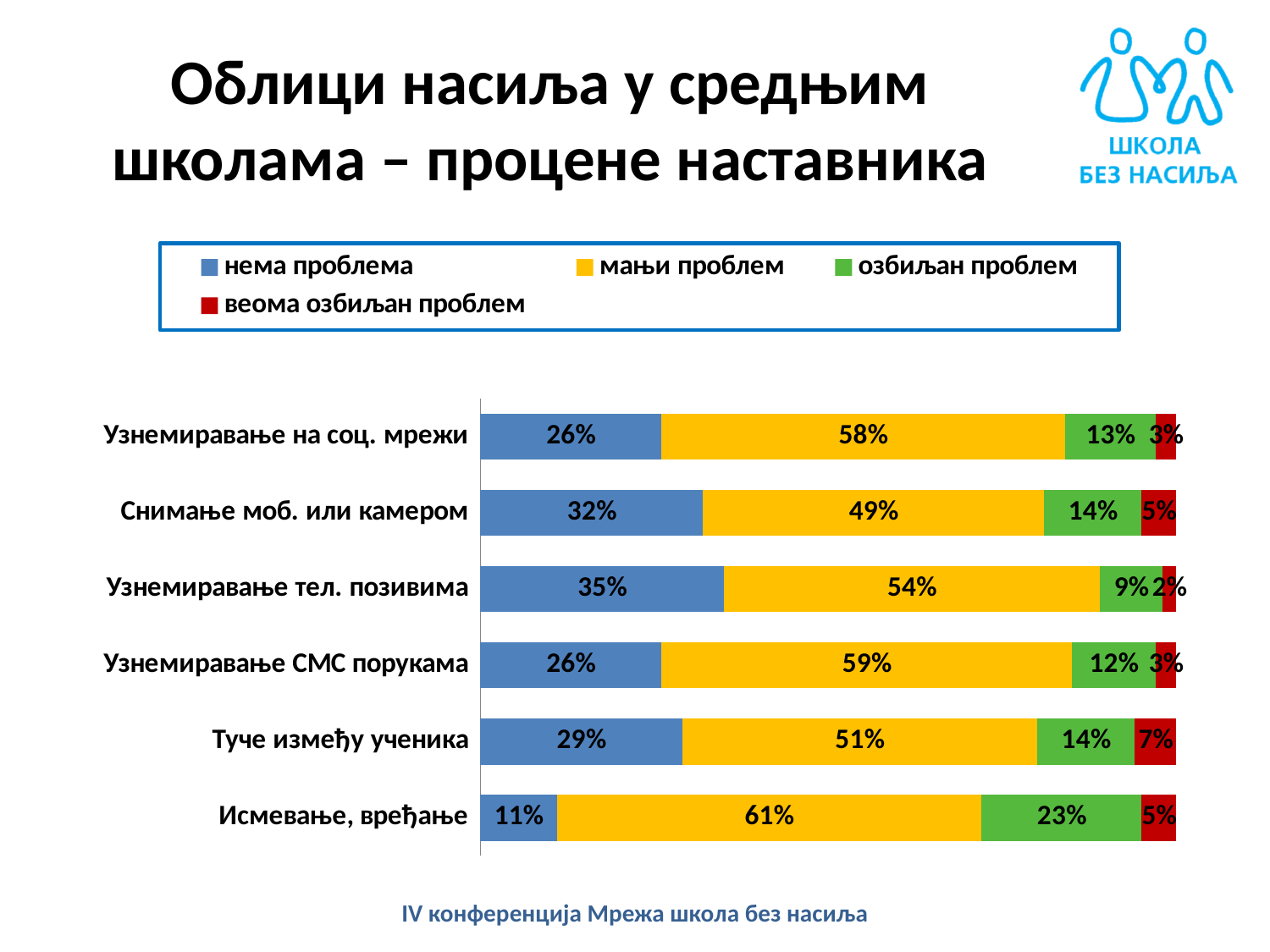
Which category has the lowest value for "нема проблема"? Исмевање, вређање How many series does the legend list? 4 What is the difference between the "нема проблема" values for "Снимање моб. или камером" and "Узнемиравање СМС порукама"? 6% What is the value of "нема проблема" for "Узнемиравање тел. позивима"? 35% How many categories are plotted on the chart? 6 Which is larger: the "мањи проблем" value for "Узнемиравање СМС порукама" or for "Туче између ученика"? Узнемиравање СМС порукама Which colour represents "веома озбиљан проблем" in the legend? red What is the total of the stacked bar for "Снимање моб. или камером"? 100% What is the value of "мањи проблем" for "Исмевање, вређање"? 61% Which category has the highest value for "озбиљан проблем"? Исмевање, вређање What is the value of "веома озбиљан проблем" for "Туче између ученика"? 7% What kind of chart is shown on the slide? stacked bar chart